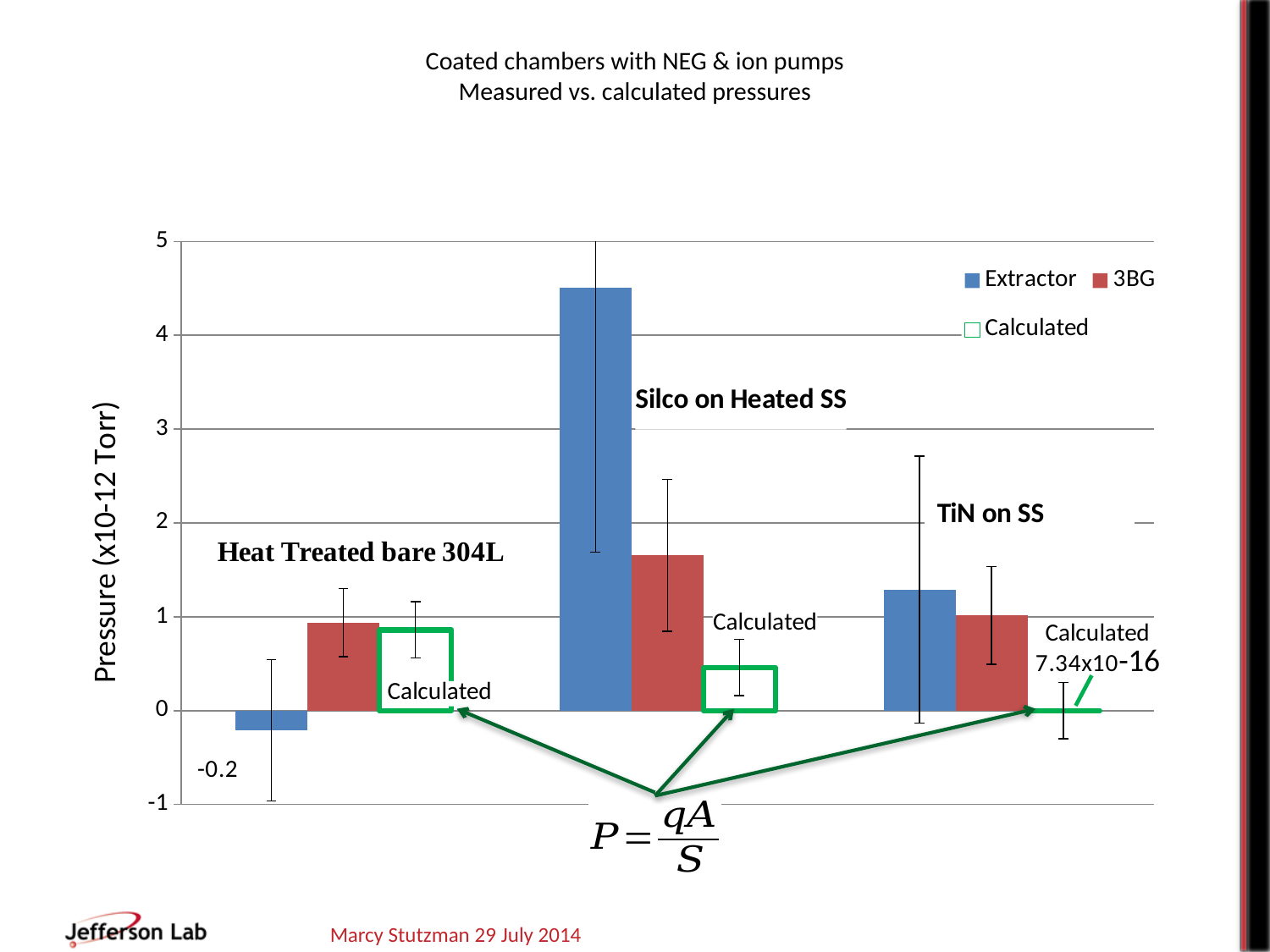
Is the 3BG value for Silco on Heated SS greater or less than 2? less What is the Calculated value for TiN on SS? 7.34x10-16 What kind of chart is shown on the slide? bar chart Which category has the highest Extractor bar? Silco on Heated SS For Heat Treated bare 304L, which is larger, the Extractor bar or the 3BG bar? 3BG What is the Extractor value for Heat Treated bare 304L? -0.2 How many chamber categories are plotted in the chart? 3 What is the label on the vertical axis of the chart? Pressure (x10-12 Torr) Which category has the lowest Extractor bar? Heat Treated bare 304L Is the Extractor value for Silco on Heated SS greater or less than 4? greater For Silco on Heated SS, which is larger, the Extractor bar or the 3BG bar? Extractor How many series does the chart legend list? 3